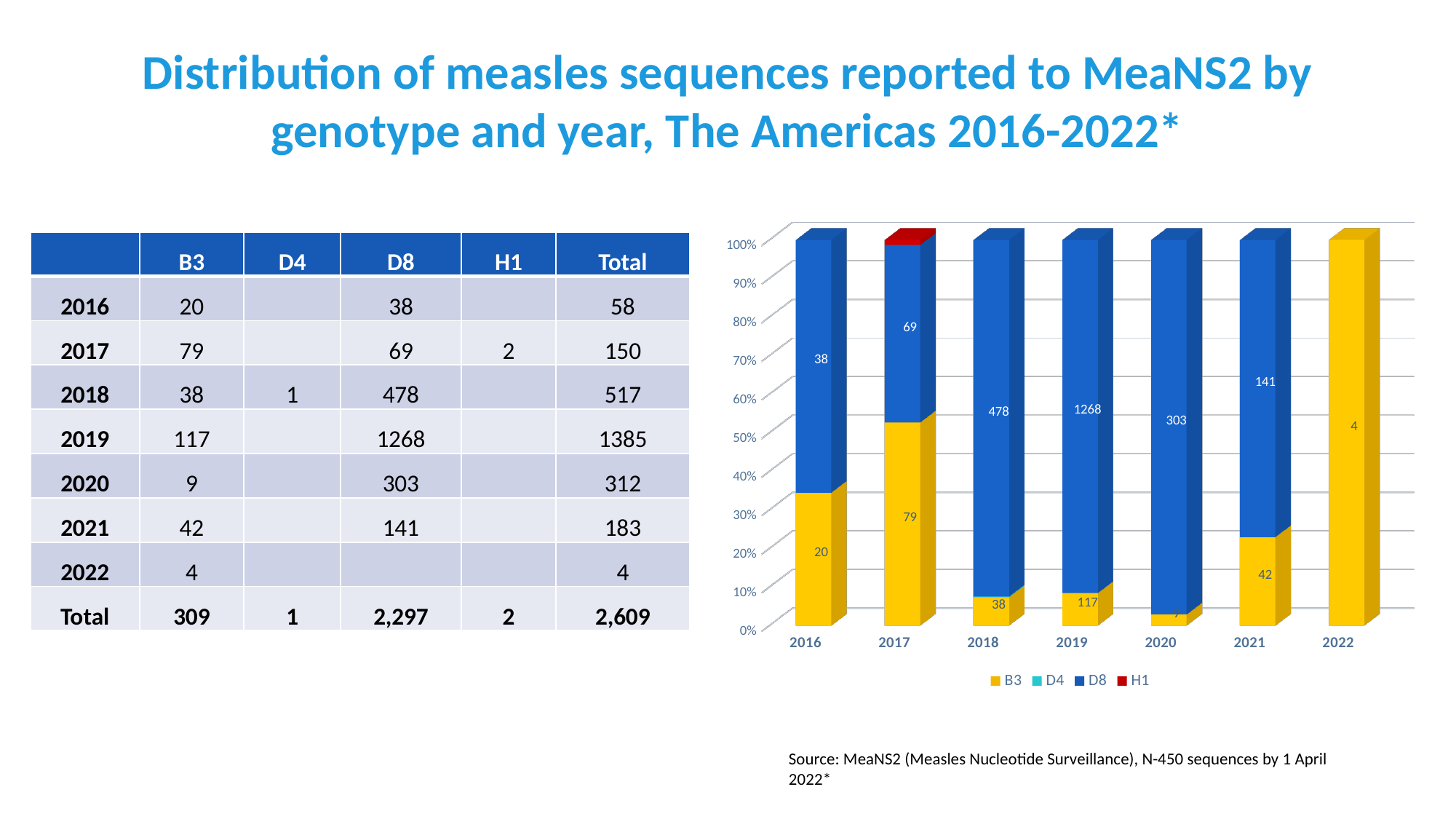
Which year has the highest labelled D8 value in the chart? 2019 Which is larger in the chart, the B3 value for 2017 or the D8 value for 2017? B3 value for 2017 What is the D8 value labelled on the 2019 bar? 1268 What is the D8 value labelled on the 2021 bar? 141 How many years are shown on the x axis of the chart? 7 What is the B3 value labelled on the 2022 bar? 4 How many series does the chart legend list? 4 What is the difference between the D8 values labelled for 2018 and 2020? 175 Which series is shown in red in the chart legend? H1 What is the B3 value labelled on the 2017 bar? 79 What type of chart is shown on the right of the slide? stacked bar chart Is the B3 share of the 2016 bar greater or less than 30%? greater